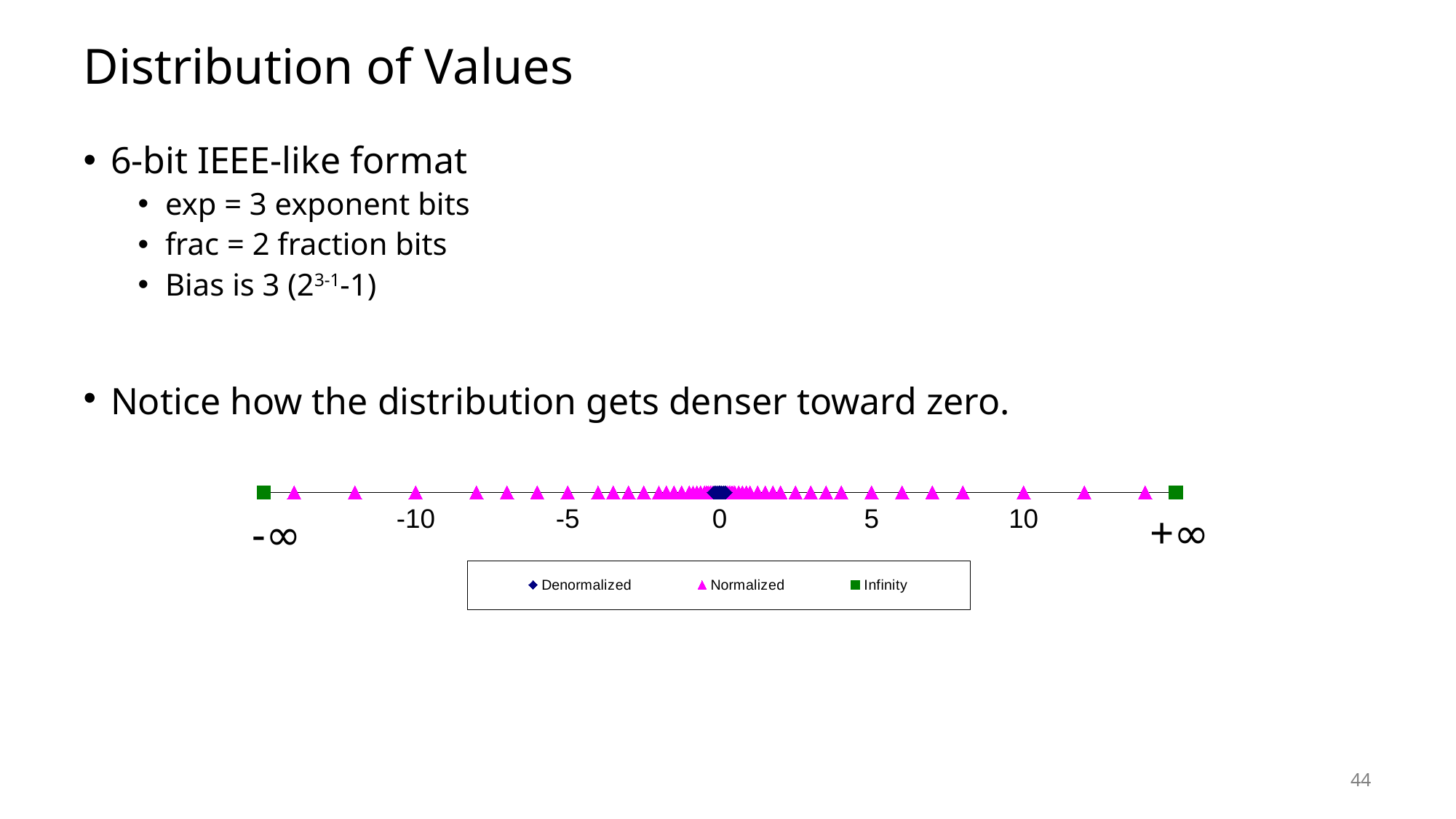
What kind of chart is shown on the slide? scatter chart Which series is shown with magenta triangle markers? Normalized How many Infinity points are plotted on the number line? 2 Which series is shown with green square markers? Infinity What label appears at the far right end of the axis? +∞ Which series has the fewest plotted points? Infinity Around which value on the axis are the plotted points densest? 0 Which series has the most plotted points? Normalized How many series does the legend list? 3 Which series lies closer to zero, Denormalized or Normalized? Denormalized What label appears at the far left end of the axis? -∞ How many numeric tick labels are shown on the axis between the infinity labels? 5